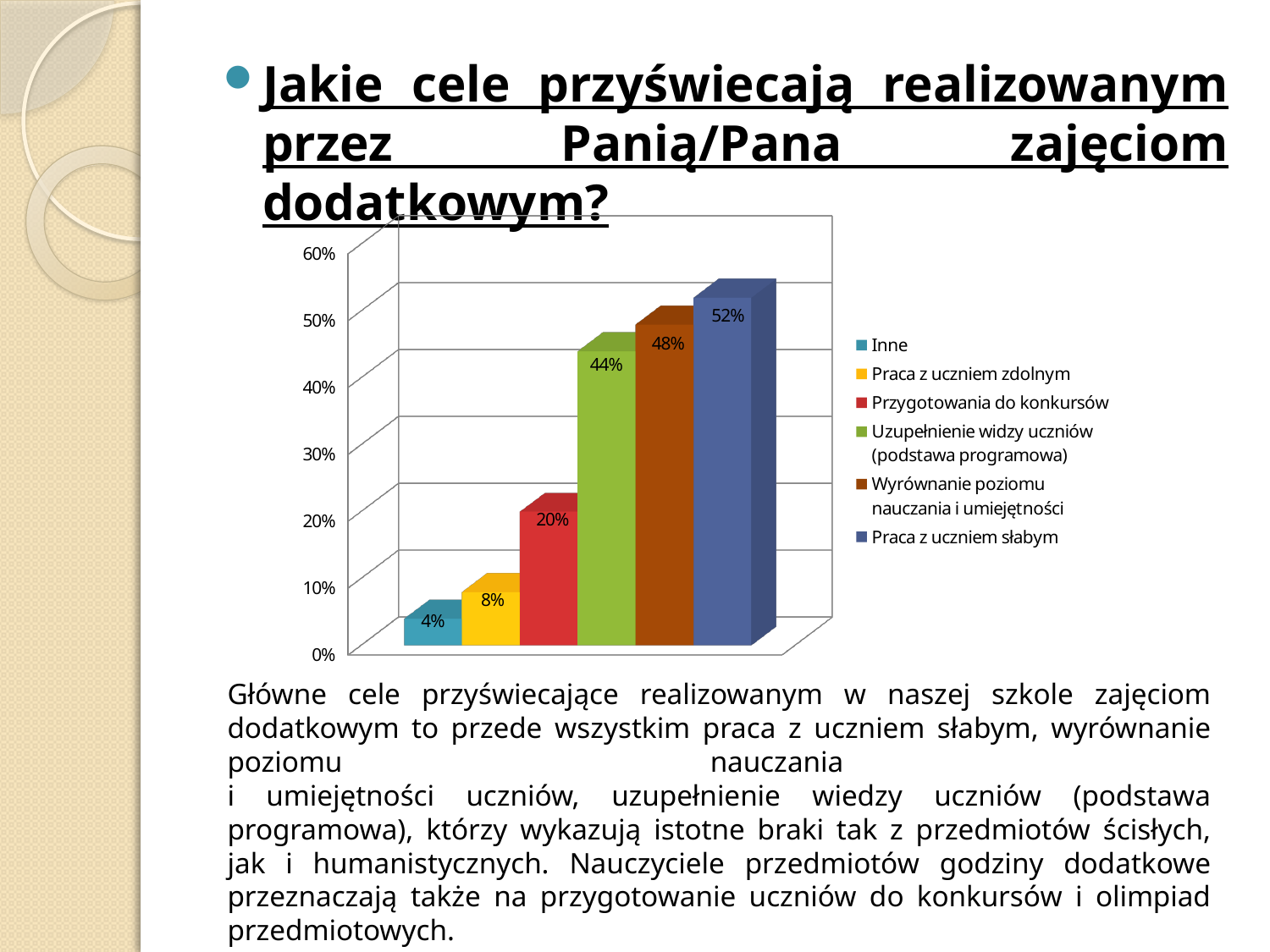
What percentage is shown for "Praca z uczniem słabym"? 52% Which is larger: the value for "Praca z uczniem zdolnym" or the value for "Przygotowania do konkursów"? Przygotowania do konkursów Which category has the highest value in the chart? Praca z uczniem słabym What is the difference between the values for "Praca z uczniem słabym" and "Wyrównanie poziomu nauczania i umiejętności"? 4% What percentage is shown for "Inne"? 4% Is the value for "Wyrównanie poziomu nauczania i umiejętności" greater or less than 40%? greater How many entries does the legend list? 6 What kind of chart is shown on the slide? Bar chart What percentage is shown for "Przygotowania do konkursów"? 20% What percentage is shown for "Uzupełnienie widzy uczniów (podstawa programowa)"? 44% How many bars are plotted in the chart? 6 Which category has the lowest value in the chart? Inne